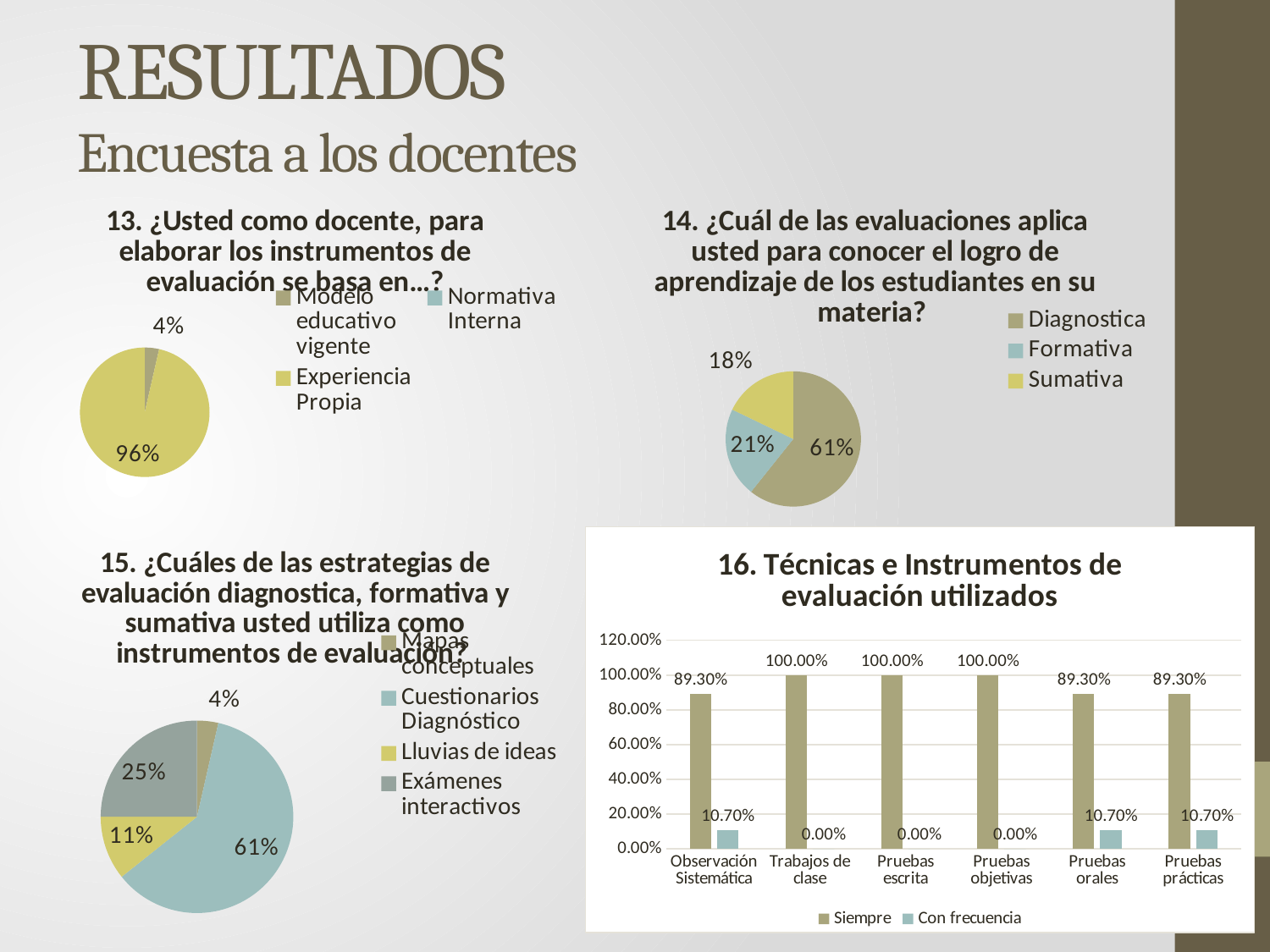
In the chart for question 14, which category has the smallest slice? Sumativa In the chart for question 15, which category has the largest slice? Cuestionarios Diagnóstico In the chart for question 14, what percentage is shown for Formativa? 21% In the chart '16. Técnicas e Instrumentos de evaluación utilizados', how many categories are shown on the x axis? 6 In the chart for question 15 (¿Cuáles de las estrategias de evaluación...?), what percentage is shown for Exámenes interactivos? 25% In the chart for question 14 (¿Cuál de las evaluaciones aplica usted...?), what percentage is shown for Diagnostica? 61% In the chart '16. Técnicas e Instrumentos de evaluación utilizados', what is the Siempre value for Pruebas orales? 89.30% What kind of chart is '16. Técnicas e Instrumentos de evaluación utilizados'? Bar chart In the chart for question 13, how many entries does the legend list? 3 In the chart '16. Técnicas e Instrumentos de evaluación utilizados', what is the Con frecuencia value for Trabajos de clase? 0.00% In the chart for question 13 (¿Usted como docente, para elaborar los instrumentos de evaluación se basa en...?), what percentage is shown for Experiencia Propia? 96% In the chart for question 15, what is the difference between the Cuestionarios Diagnóstico slice and the Lluvias de ideas slice? 50%